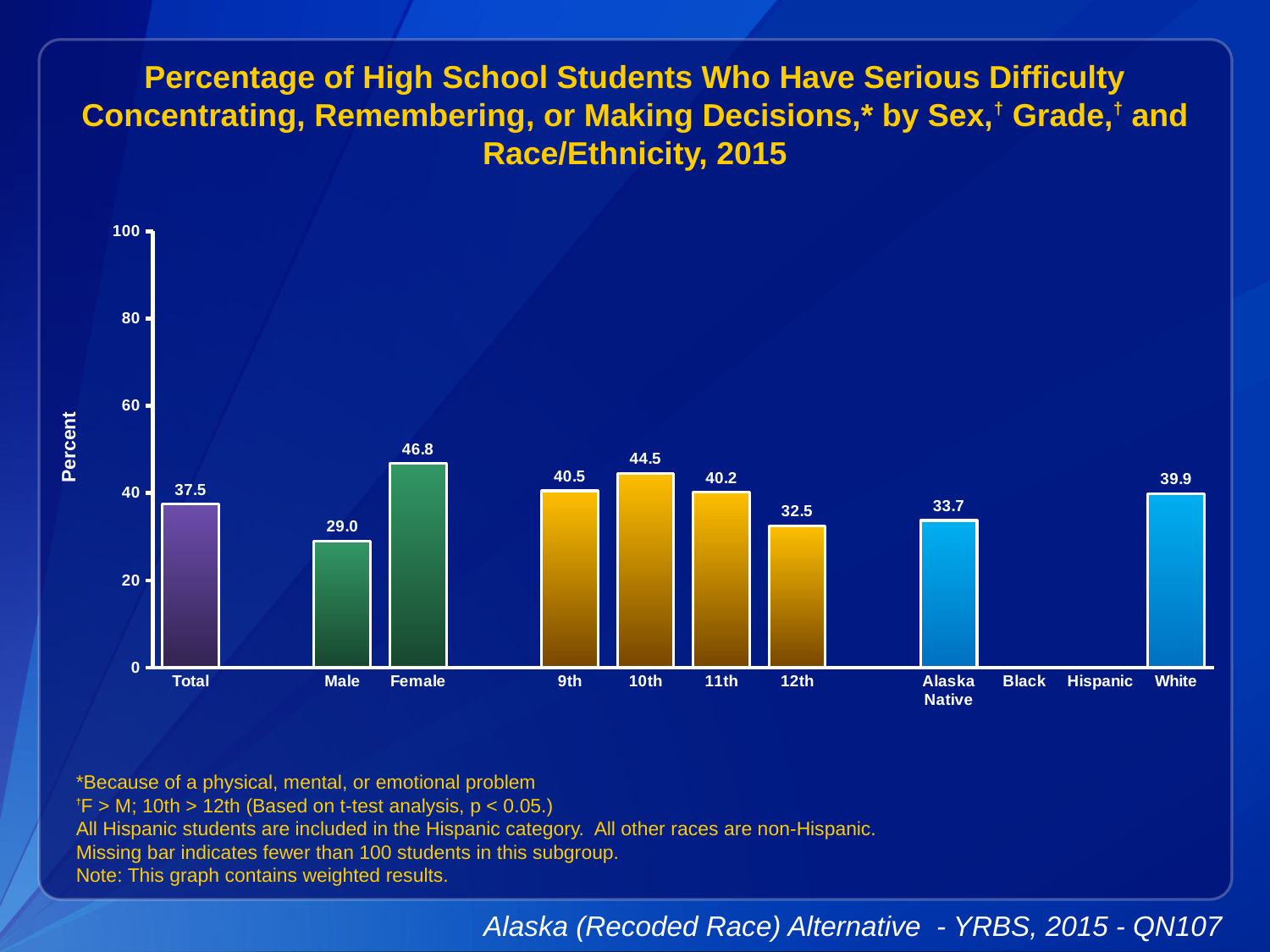
Which category with a plotted bar has the lowest value? Male What is the value for Female? 46.8 Is the value for White greater or less than 20? greater What is the value for Alaska Native? 33.7 What is the difference between the Female and Male values? 17.8 Which is larger, the value for 10th grade or the value for 12th grade? 10th What kind of chart is shown on the slide? bar chart How many categories have a bar plotted on the chart? 9 What is the label on the vertical axis? Percent What is the value for 12th grade? 32.5 Do the values fall or rise from 10th grade to 12th grade? fall Which category has the highest value? Female